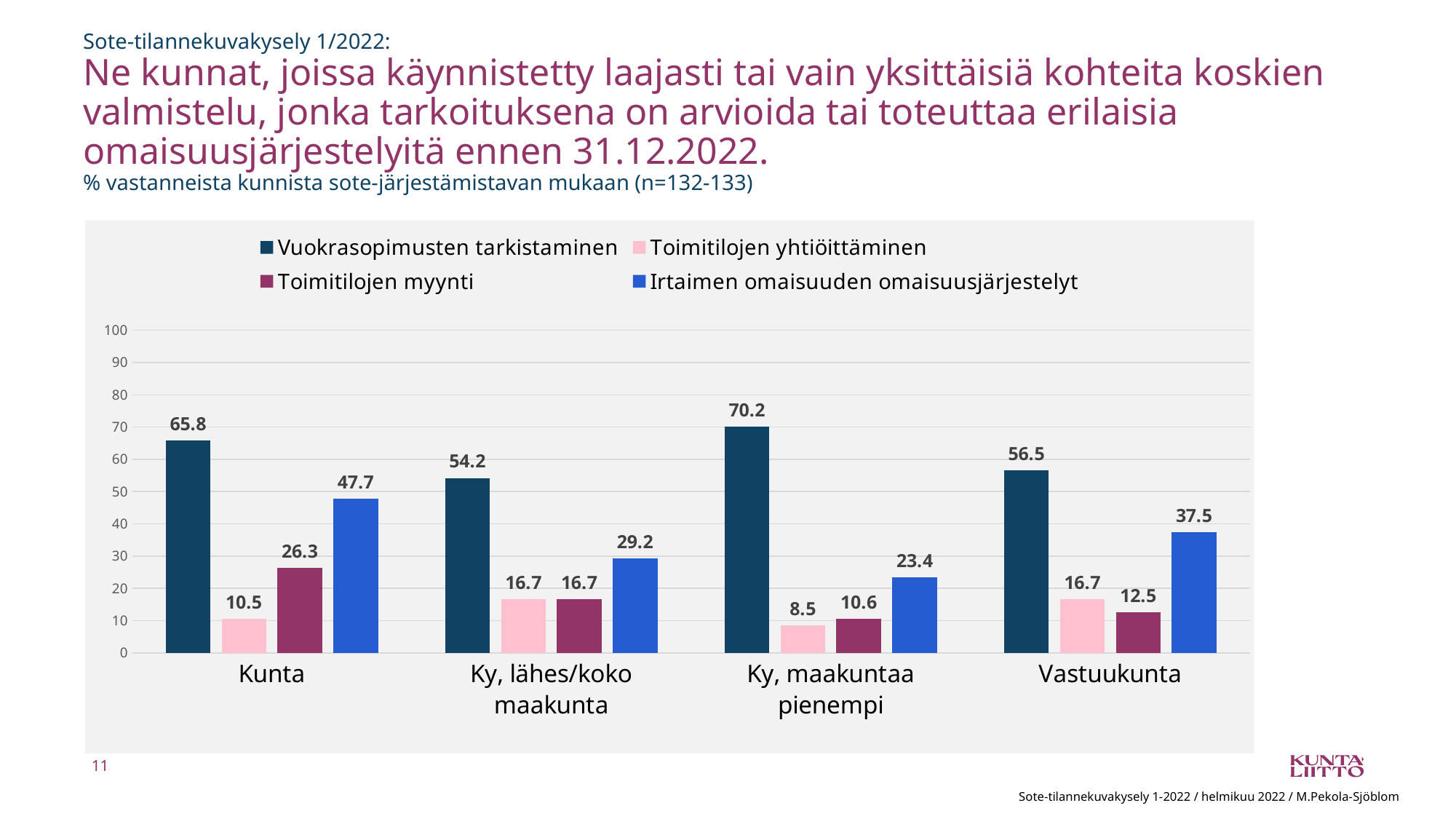
What kind of chart is shown on the slide? bar chart What is the value for Toimitilojen yhtiöittäminen in the Ky, maakuntaa pienempi category? 8.5 What is the value for Vuokrasopimusten tarkistaminen in the Kunta category? 65.8 Which colour represents Toimitilojen myynti in the legend? purple How many series does the legend list? 4 Which category has the lowest value for Toimitilojen myynti? Ky, maakuntaa pienempi Is the value for Irtaimen omaisuuden omaisuusjärjestelyt in the Ky, lähes/koko maakunta category greater or less than 30? less Which is larger in the Vastuukunta category: Toimitilojen yhtiöittäminen or Toimitilojen myynti? Toimitilojen yhtiöittäminen What is the difference between Vuokrasopimusten tarkistaminen and Irtaimen omaisuuden omaisuusjärjestelyt in the Kunta category? 18.1 Which category has the highest value for Vuokrasopimusten tarkistaminen? Ky, maakuntaa pienempi What is the value for Irtaimen omaisuuden omaisuusjärjestelyt in the Vastuukunta category? 37.5 How many categories are shown on the x axis? 4